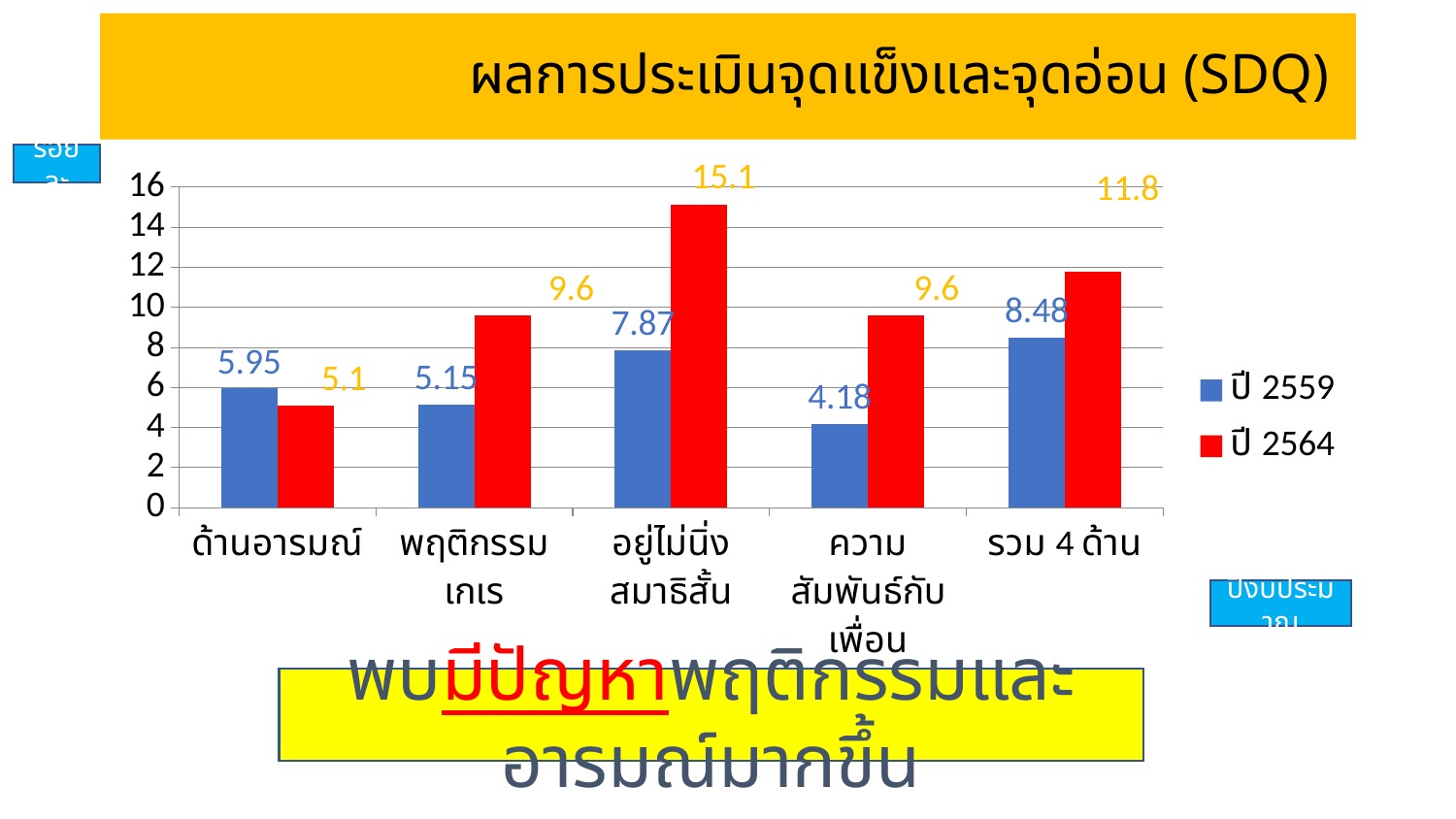
What is the difference between the ปี 2564 and ปี 2559 values in the อยู่ไม่นิ่งสมาธิสั้น category? 7.23 Which category has the lowest value for ปี 2559? ความสัมพันธ์กับเพื่อน What is the value for ปี 2564 in the รวม 4 ด้าน category? 11.8 Is the ปี 2564 value for พฤติกรรมเกเร greater or less than 8? greater What is the value for ปี 2559 in the ด้านอารมณ์ category? 5.95 What is the value for ปี 2559 in the ความสัมพันธ์กับเพื่อน category? 4.18 Which category has the highest value for ปี 2564? อยู่ไม่นิ่งสมาธิสั้น What is the value for ปี 2564 in the อยู่ไม่นิ่งสมาธิสั้น category? 15.1 What type of chart is shown on the slide? bar chart In the ด้านอารมณ์ category, which series has the larger value, ปี 2559 or ปี 2564? ปี 2559 How many categories are shown on the x axis? 5 How many series does the legend list? 2